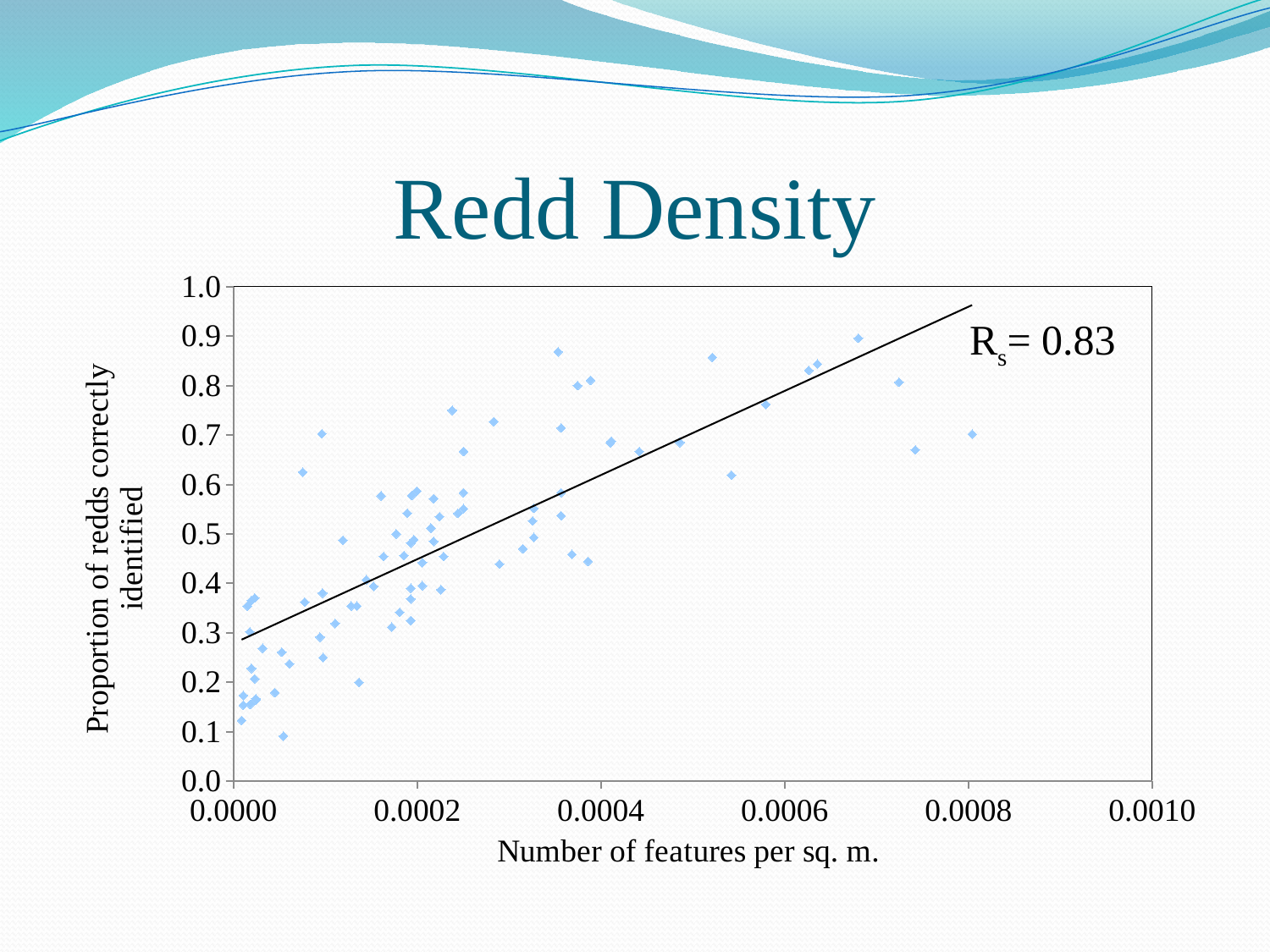
What is the label of the x axis? Number of features per sq. m. What is the title of the chart? Redd Density Is the lowest plotted point's proportion of redds correctly identified greater or less than 0.2? less What value of R_s is printed on the chart? 0.83 Does the fitted line slope upward or downward from left to right? upward Do the plotted values generally rise or fall as the number of features per sq. m. increases? rise What is the highest value shown on the y axis? 1.0 Is the highest plotted point's proportion of redds correctly identified greater or less than 0.8? greater What kind of chart is shown on the slide? scatter plot What is the highest value shown on the x axis? 0.0010